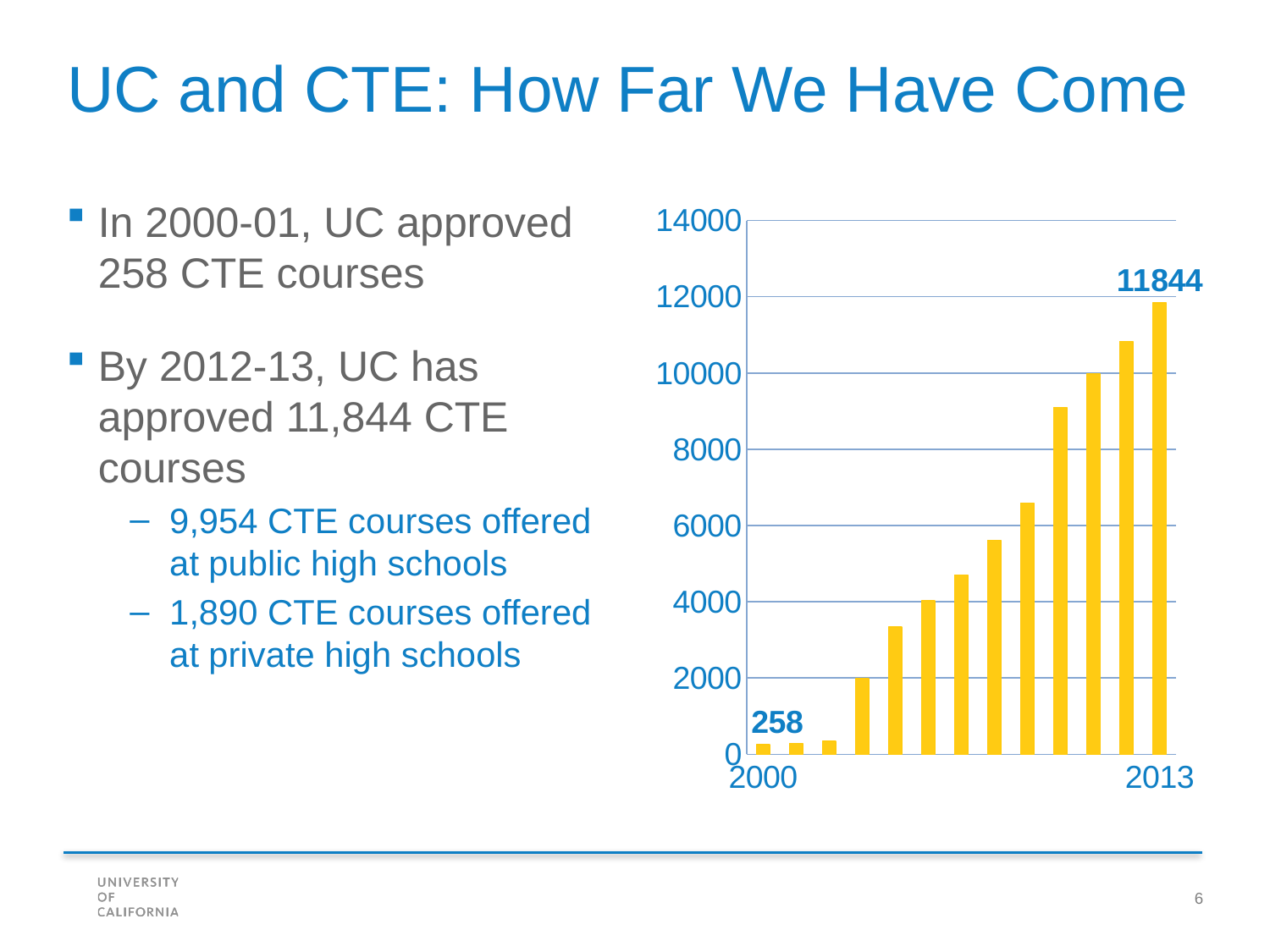
Which year has the highest bar in the chart? 2013 Is the value for 2000 greater or less than 2000? less What value is labeled on the bar for 2000? 258 What kind of chart is shown on the slide? bar chart Is the value for 2013 greater or less than 10000? greater Which is larger, the value for 2000 or the value for 2013? 2013 Do the values rise or fall from 2000 to 2013? rise What is the highest value shown on the y axis? 14000 What colour are the bars in the chart? yellow What value is labeled on the bar for 2013? 11844 What is the difference between the labeled values for 2013 and 2000? 11586